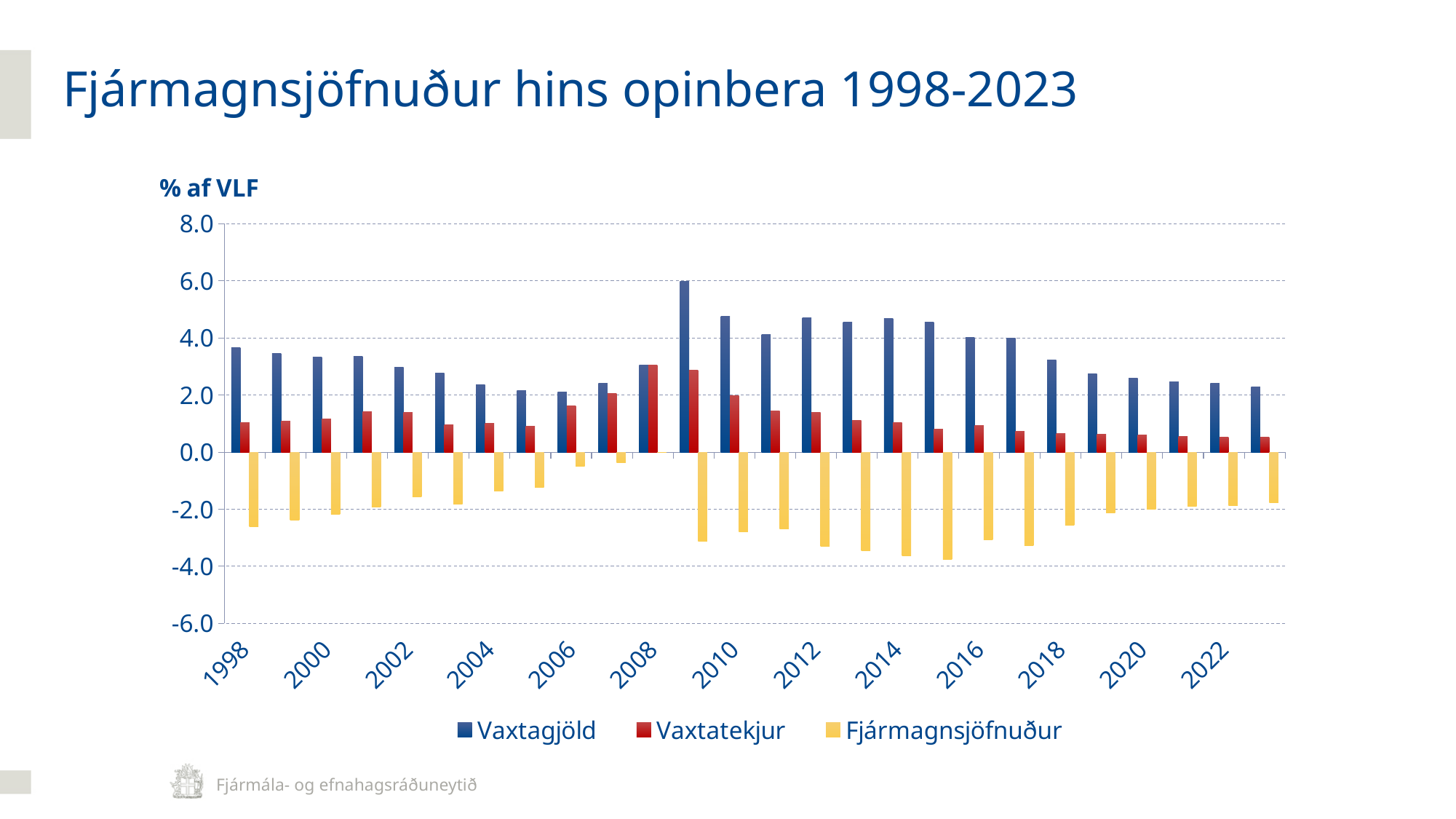
What kind of chart is shown on the slide? bar chart In which year is Vaxtatekjur highest? 2008 How many years (bar groups) are plotted on the x axis? 26 In which year is Vaxtagjöld highest? 2009 Is the value for Vaxtagjöld in 2009 greater or less than 4.0? greater Does Vaxtagjöld rise or fall from 2009 to 2023? fall Which is larger, Vaxtagjöld in 2009 or Vaxtagjöld in 2010? 2009 How many series does the legend list? 3 Is the value for Fjármagnsjöfnuður in 2015 greater or less than -2.0? less Is the value for Vaxtatekjur in 2008 greater or less than 2.0? greater What unit label is shown above the y axis? % af VLF In which year is Fjármagnsjöfnuður lowest (most negative)? 2015